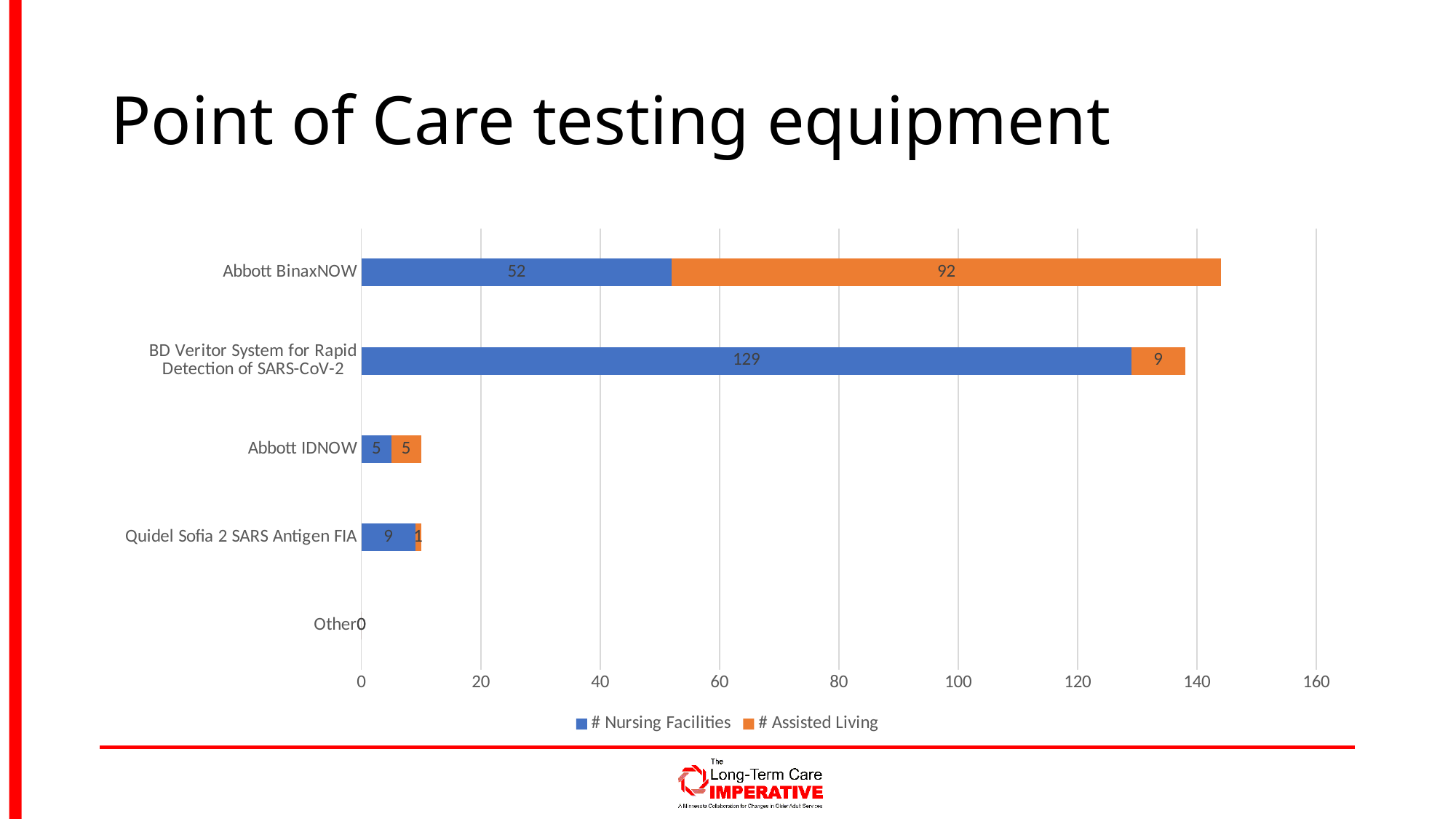
Which category has the highest # Assisted Living value? Abbott BinaxNOW What is the # Assisted Living value for Quidel Sofia 2 SARS Antigen FIA? 1 What is the # Nursing Facilities value for Abbott BinaxNOW? 52 Which category has the highest # Nursing Facilities value? BD Veritor System for Rapid Detection of SARS-CoV-2 What is the difference between the # Nursing Facilities and # Assisted Living values for BD Veritor System for Rapid Detection of SARS-CoV-2? 120 How many categories are shown on the chart? 5 Which is larger for Abbott BinaxNOW: # Nursing Facilities or # Assisted Living? # Assisted Living What is the # Assisted Living value for Abbott BinaxNOW? 92 What kind of chart is shown on the slide? Stacked bar chart What is the total of the stacked bar for Abbott BinaxNOW? 144 What is the # Nursing Facilities value for BD Veritor System for Rapid Detection of SARS-CoV-2? 129 How many series does the legend list? 2